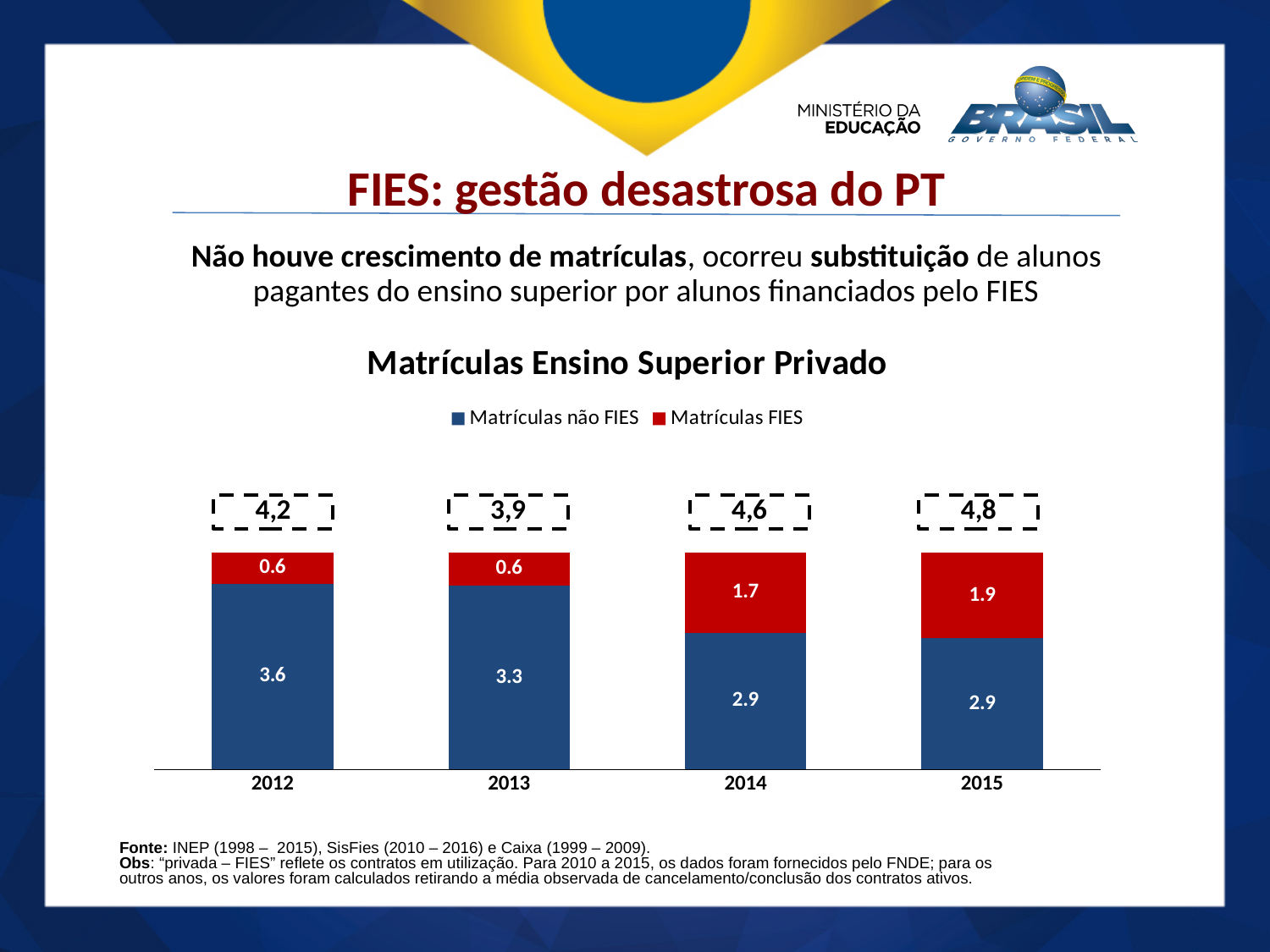
Which colour represents Matrículas FIES in the chart? Red How many series does the legend list? 2 Which year has the lowest total of Matrículas Ensino Superior Privado? 2013 What is the value of Matrículas não FIES for 2013? 3.3 What kind of chart is shown on the slide? Stacked bar chart What is the difference between the Matrículas não FIES value in 2012 and in 2015? 0.7 Does the Matrículas FIES value rise or fall from 2012 to 2015? Rise What is the total shown above the stacked bar for 2015? 4,8 In 2014, which is larger: Matrículas FIES or Matrículas não FIES? Matrículas não FIES How many years are shown on the x axis of the chart? 4 What is the value of Matrículas FIES for 2014? 1.7 In which year is the Matrículas FIES value the highest? 2015